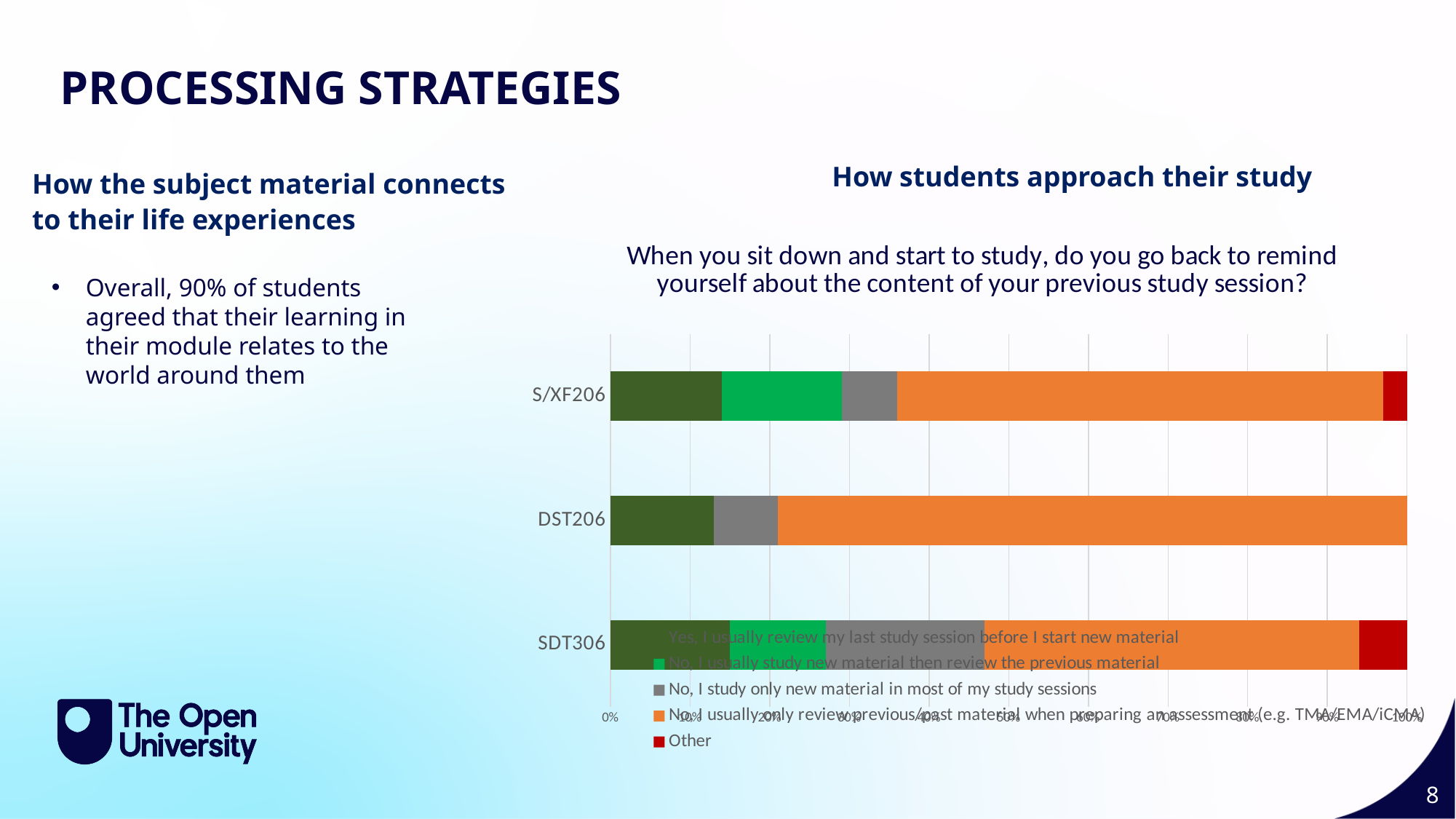
Is the 'Yes, I usually review my last study session before I start new material' share for S/XF206 greater or less than 20%? less Which module has the largest segment for 'No, I usually only review previous/past material when preparing an assessment (e.g. TMA/EMA/iCMA)'? DST206 Which module has the largest segment for 'No, I study only new material in most of my study sessions'? SDT306 Is the 'No, I study only new material in most of my study sessions' segment larger for SDT306 or for DST206? SDT306 What colour represents the 'Other' series in the chart legend? Red How many series does the chart legend list? 5 Is the 'No, I study only new material in most of my study sessions' share for SDT306 greater or less than 10%? greater Is the 'No, I usually only review previous/past material when preparing an assessment' share for DST206 greater or less than 70%? greater Is the 'No, I usually only review previous/past material when preparing an assessment' segment larger for DST206 or for SDT306? DST206 How many modules (categories) are shown on the chart? 3 What kind of chart is shown under 'How students approach their study'? Stacked bar chart Which module has no 'No, I usually study new material then review the previous material' segment? DST206